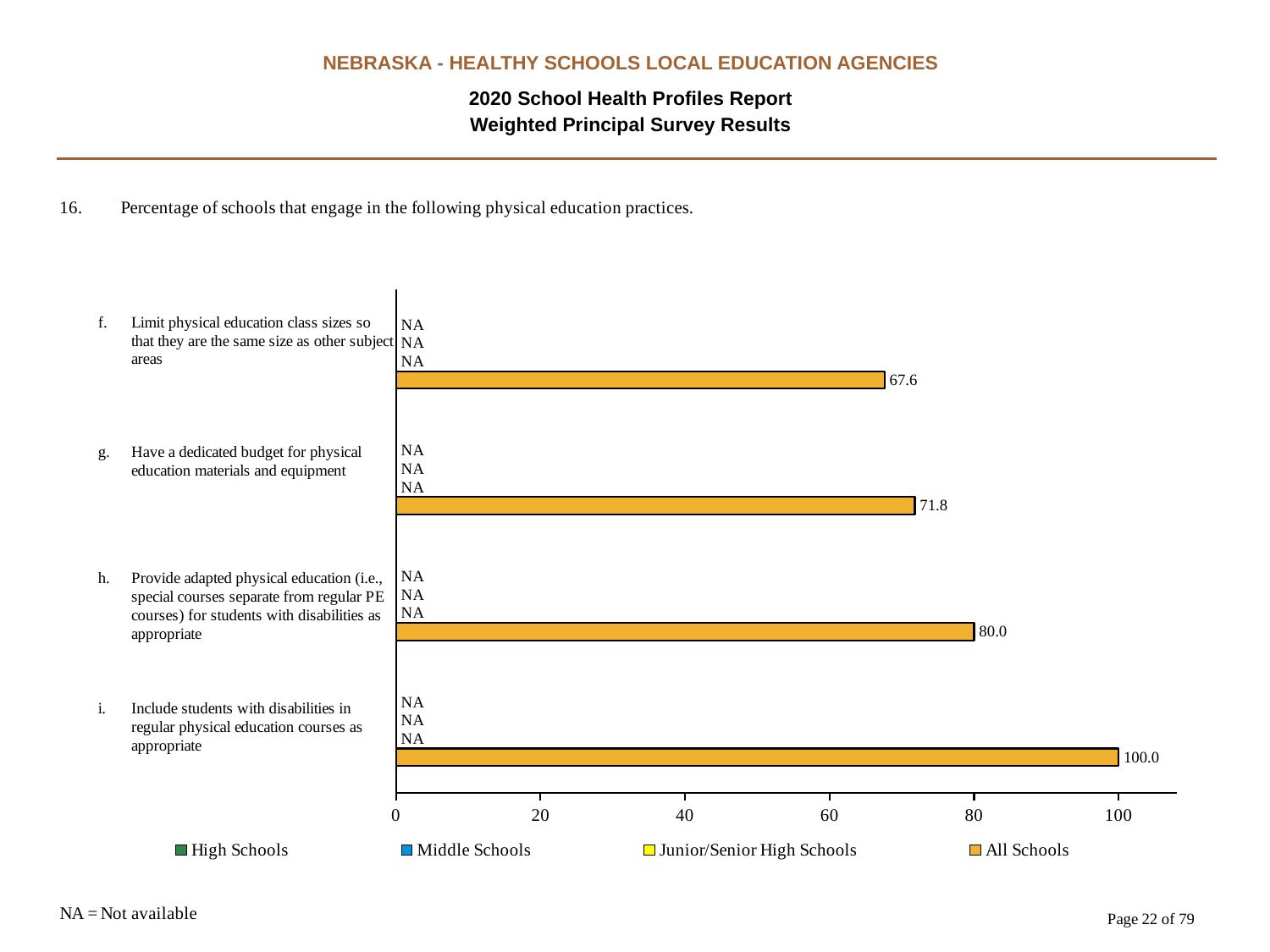
What value is shown for High Schools for 'Have a dedicated budget for physical education materials and equipment'? NA What kind of chart is shown on the slide? Bar chart What is the All Schools value for 'Include students with disabilities in regular physical education courses as appropriate'? 100.0 What is the All Schools value for 'Have a dedicated budget for physical education materials and equipment'? 71.8 Which practice has the highest All Schools percentage? Include students with disabilities in regular physical education courses as appropriate What is the All Schools value for 'Limit physical education class sizes so that they are the same size as other subject areas'? 67.6 Which practice has the lowest All Schools percentage? Limit physical education class sizes so that they are the same size as other subject areas What is the difference between the All Schools values for item i (include students with disabilities) and item f (limit class sizes)? 32.4 How many physical education practices are listed in the chart? 4 What is the All Schools value for 'Provide adapted physical education for students with disabilities as appropriate'? 80.0 Which is larger for All Schools: the value for having a dedicated budget for PE materials or the value for providing adapted physical education? Providing adapted physical education How many series does the legend list? 4